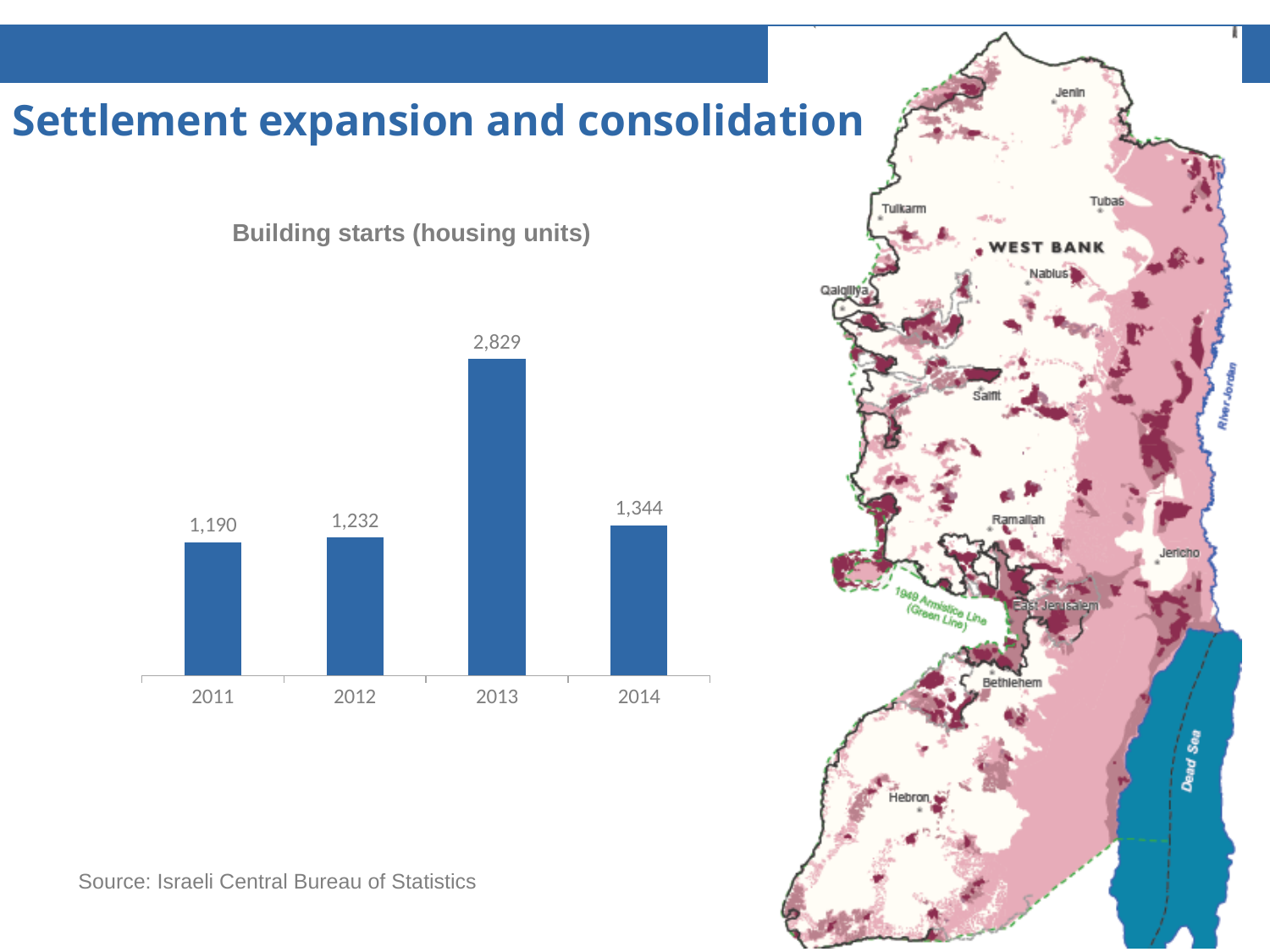
How many years are shown in the Building starts chart? 4 What is the value for 2014 in the Building starts (housing units) chart? 1,344 What is the value for 2011 in the Building starts (housing units) chart? 1,190 Did building starts rise or fall from 2013 to 2014? Fall What kind of chart is used to show building starts? Bar chart What is the difference between building starts in 2013 and 2014? 1,485 Which year had more building starts, 2012 or 2014? 2014 What is the value for 2013 in the Building starts (housing units) chart? 2,829 What is the source cited for the Building starts chart? Israeli Central Bureau of Statistics What is the difference between building starts in 2012 and 2011? 42 Which year has the lowest number of building starts? 2011 Which year has the highest number of building starts? 2013